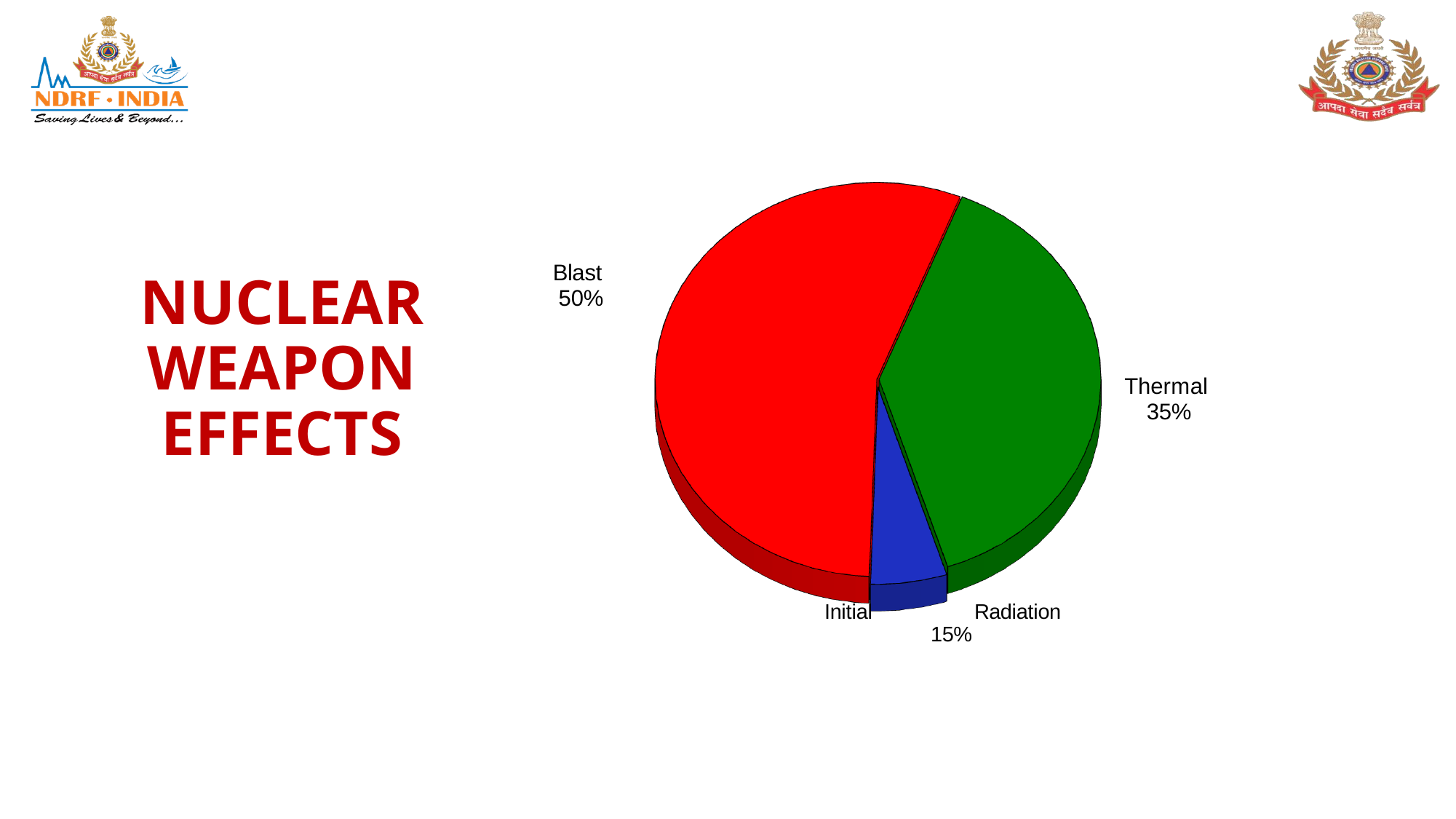
What is the difference in percentage points between Thermal and Initial Radiation? 20 What colour is the Blast slice? Red What percentage of nuclear weapon effects is attributed to Thermal? 35% How many slices does the pie chart have? 3 What percentage of nuclear weapon effects is attributed to Initial Radiation? 15% What is the title shown next to the chart? NUCLEAR WEAPON EFFECTS Which effect has the smallest share of the pie? Initial Radiation What is the difference in percentage points between Blast and Thermal? 15 Which effect has the largest share of the pie? Blast Which is larger, the share for Thermal or the share for Initial Radiation? Thermal What percentage of nuclear weapon effects is attributed to Blast? 50% What kind of chart is shown on the slide? Pie chart